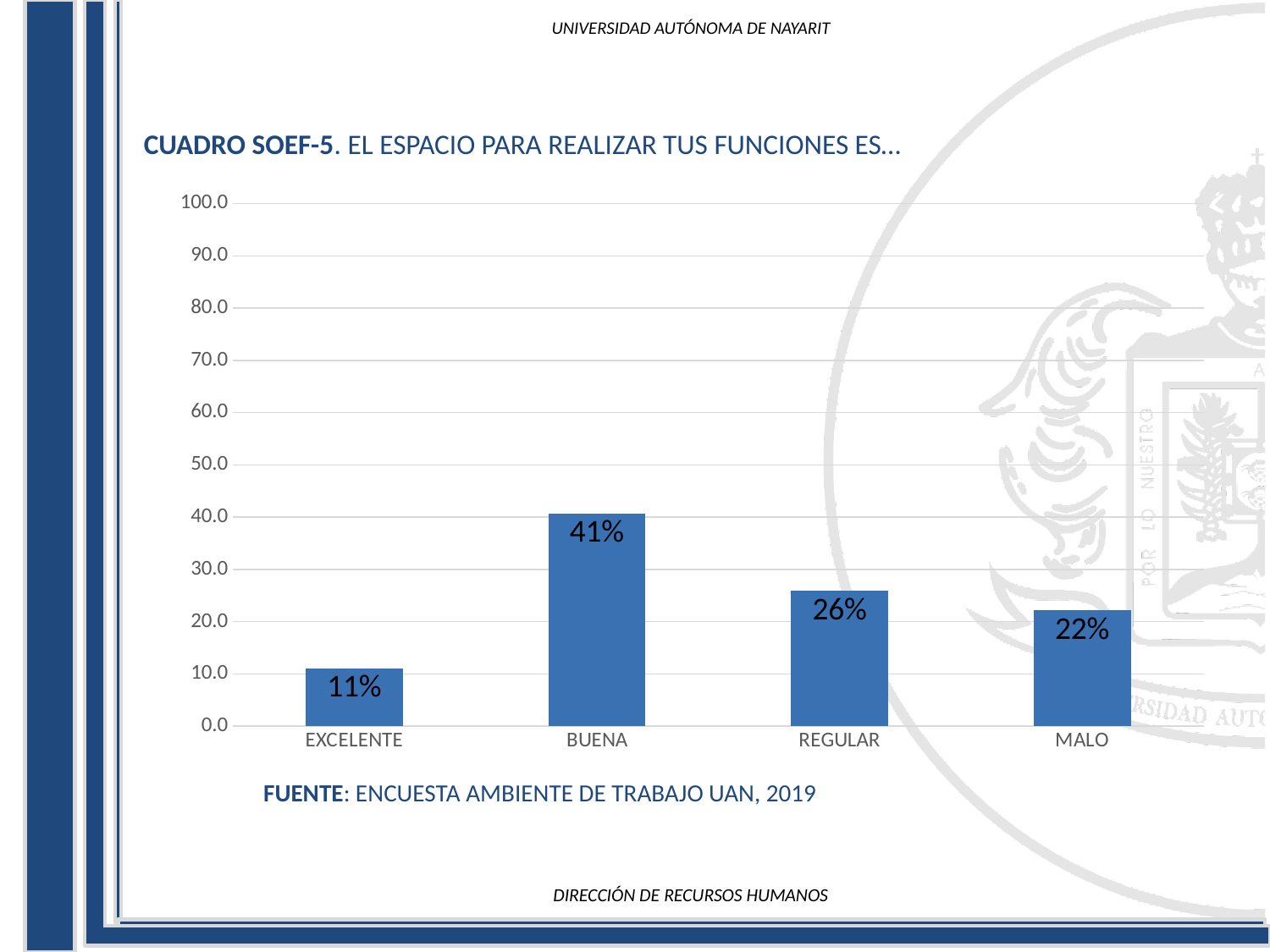
How many categories are shown on the x axis? 4 Which is larger, the value for REGULAR or the value for MALO? REGULAR What kind of chart is shown on the slide? bar chart What is the value for MALO? 22% What is the highest value shown on the y axis? 100.0 Which category has the highest value? BUENA What is the value for BUENA? 41% Is the value for BUENA greater or less than 50? less What is the source cited below the chart? ENCUESTA AMBIENTE DE TRABAJO UAN, 2019 What is the difference between the values for BUENA and REGULAR? 15% What is the value for EXCELENTE? 11% Which category has the lowest value? EXCELENTE